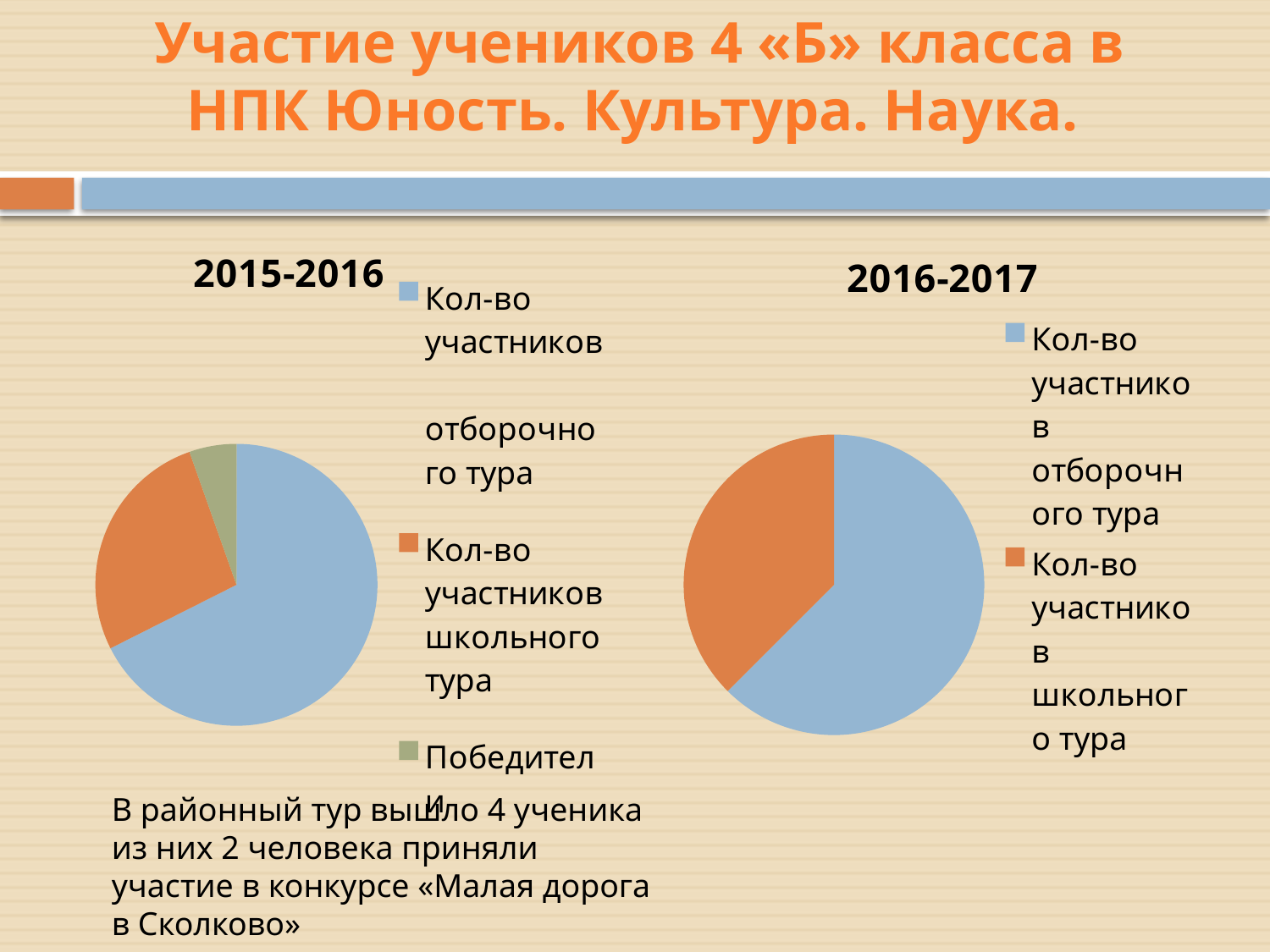
In the 2015-2016 chart, which category has the largest slice? Кол-во участников отборочного тура In the 2016-2017 chart, what colour is the slice for Кол-во участников школьного тура? orange What kind of chart is the 2015-2016 chart? pie chart What kind of chart is the 2016-2017 chart? pie chart In the 2015-2016 chart, which is larger: Кол-во участников школьного тура or Победители? Кол-во участников школьного тура In the 2015-2016 chart, how many entries does the legend list? 3 Which legend entry appears in the 2015-2016 chart but not in the 2016-2017 chart? Победители In the 2015-2016 chart, how many slices does the pie have? 3 In the 2016-2017 chart, how many slices does the pie have? 2 In the 2015-2016 chart, which category has the smallest slice? Победители In the 2016-2017 chart, which category has the larger slice? Кол-во участников отборочного тура In the 2016-2017 chart, how many entries does the legend list? 2